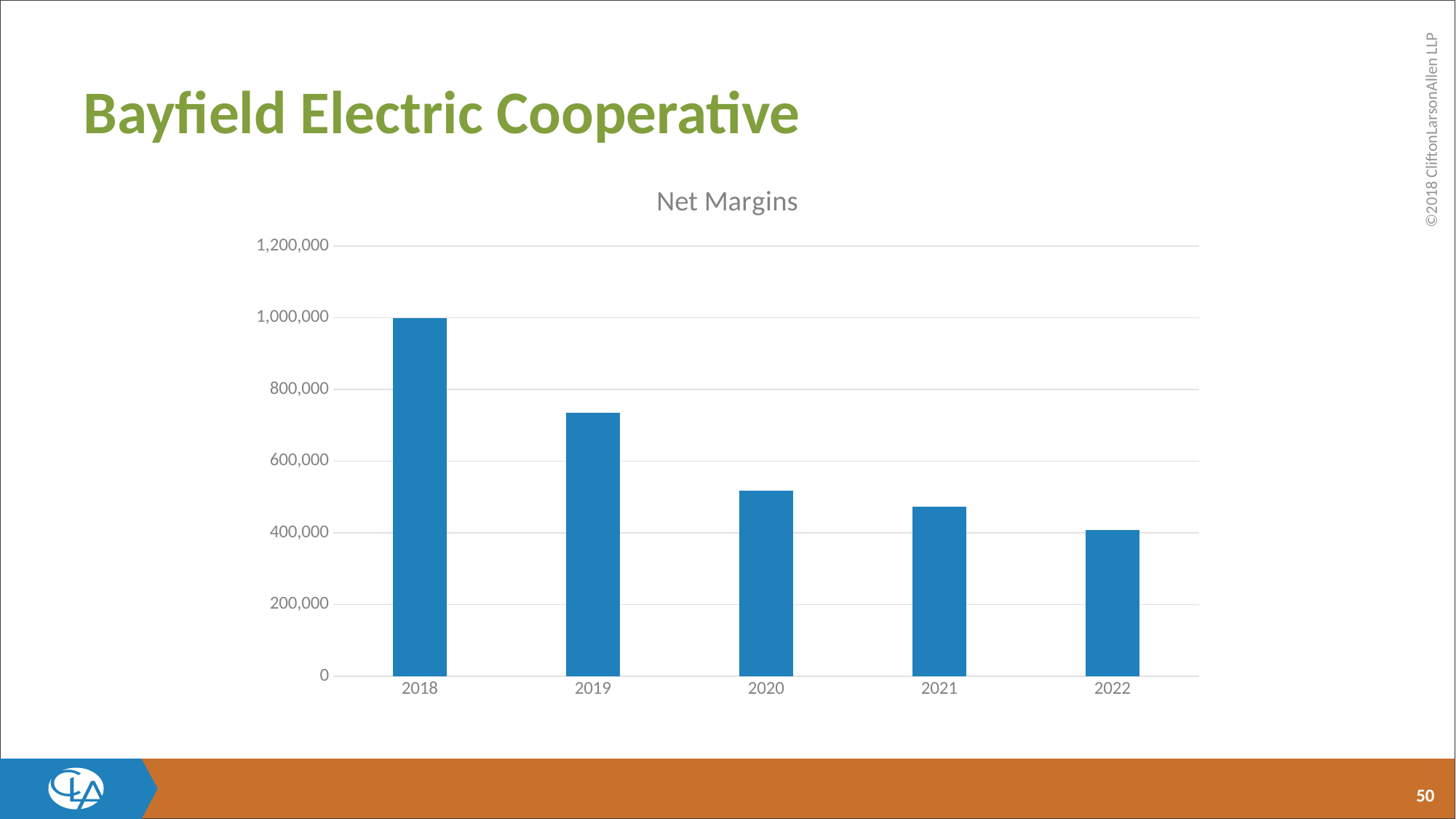
Which year has the larger net margin, 2021 or 2022? 2021 Do the net margins rise or fall from 2018 to 2022? fall Is the value for 2018 greater or less than 800,000? greater Which year has the highest net margin? 2018 Which year has the larger net margin, 2019 or 2020? 2019 What kind of chart is shown on the slide? bar chart Which year has the lowest net margin? 2022 How many years are shown on the x axis of the chart? 5 Is the value for 2020 greater or less than 600,000? less Is the value for 2022 greater or less than 600,000? less What is the title of the chart? Net Margins